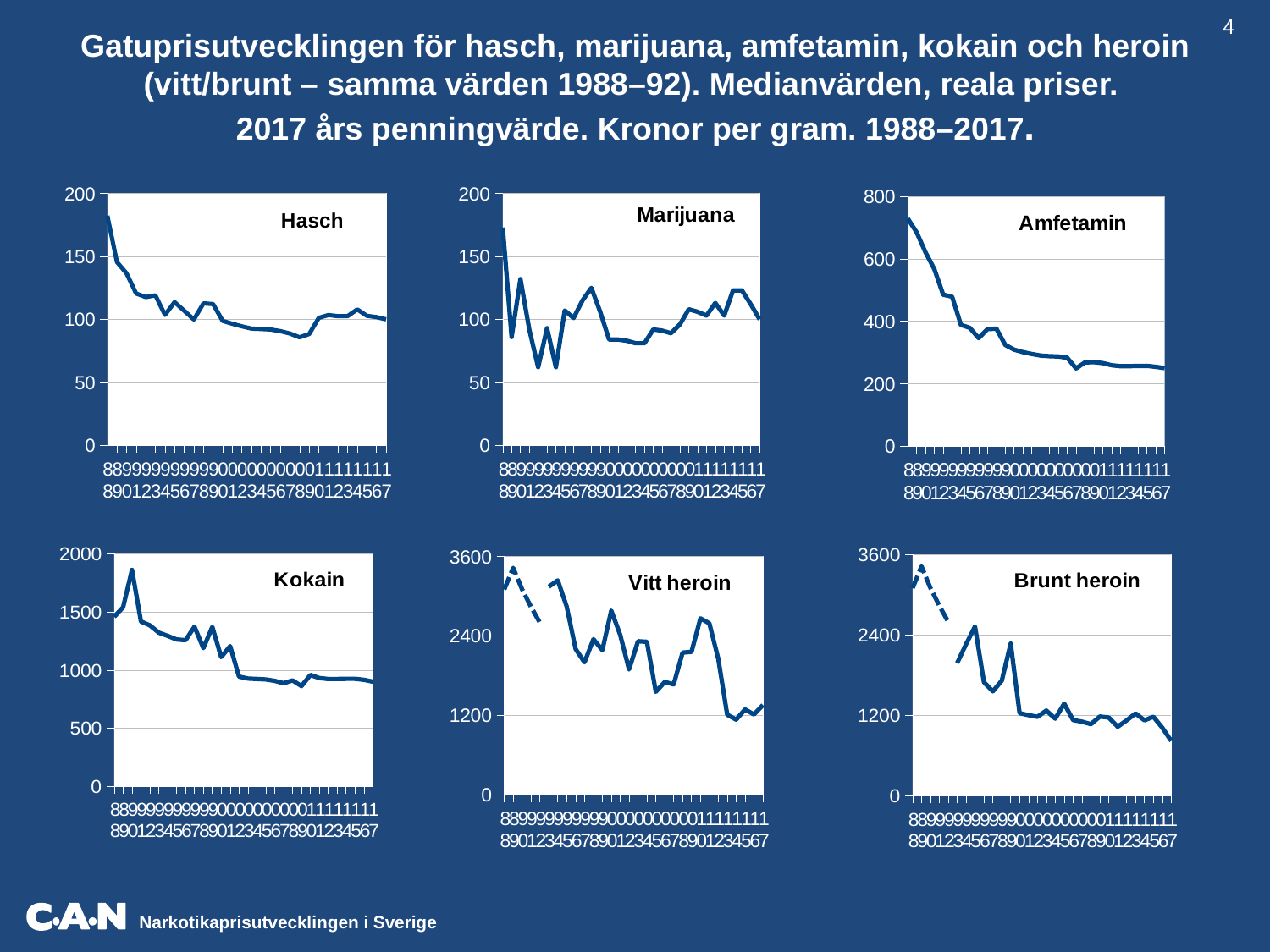
In the Hasch chart, is the value for 1988 greater or less than 150? greater How many charts are shown on the slide? 6 In the Hasch chart, do the values rise or fall from 1988 to 2017? fall In the Amfetamin chart, do the values rise or fall from 1988 to 2017? fall In the Kokain chart, do the values rise or fall from 1988 to 2017? fall In the Kokain chart, is the value for 2017 greater or less than 1000? less Which chart is in the top-right position on the slide? Amfetamin In the Brunt heroin chart, is the value for 2017 greater or less than 1200? less What is the highest value shown on the y axis of the Kokain chart? 2000 What kind of chart is the Hasch chart? line chart